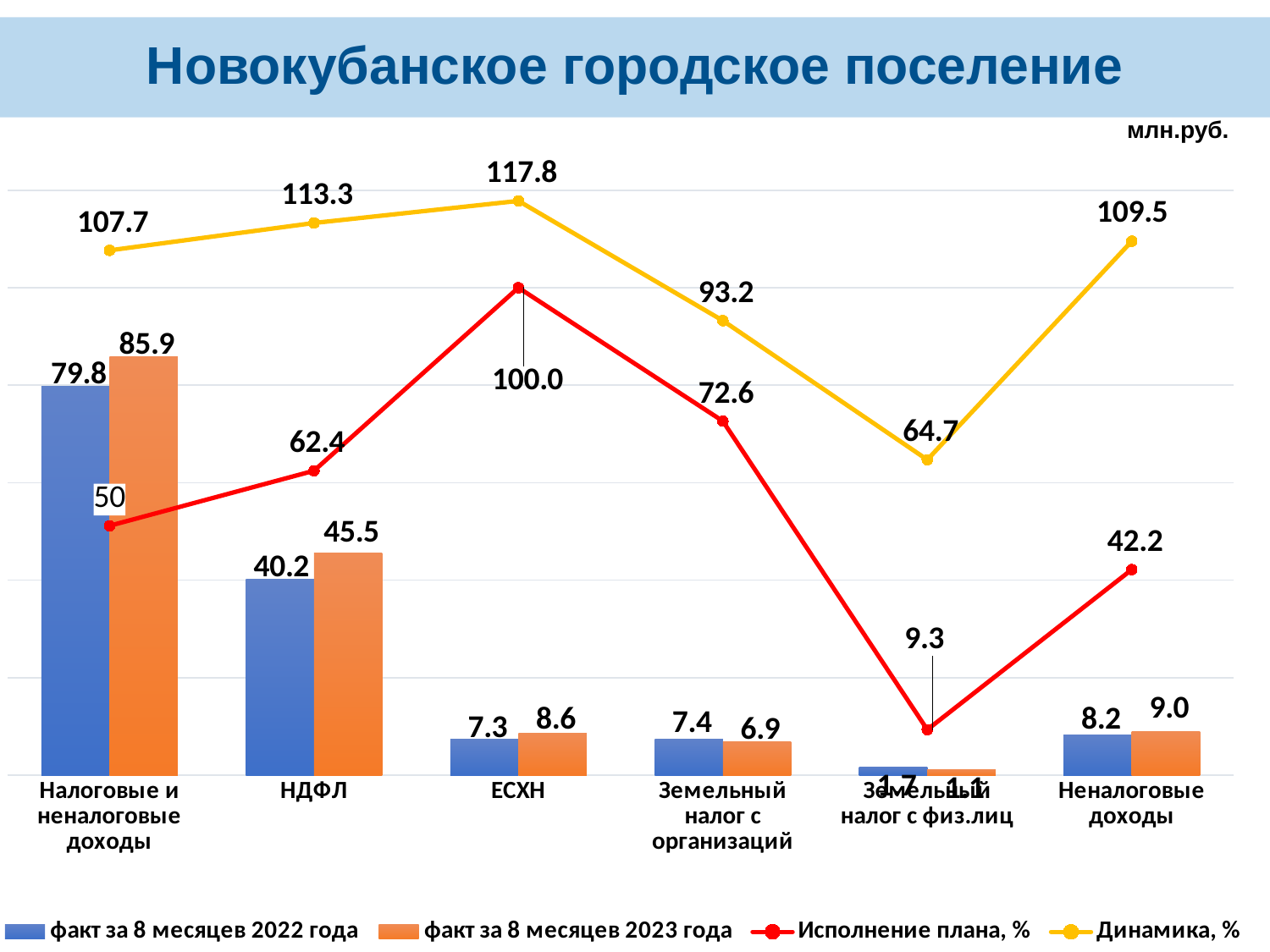
Which category has the highest 'Динамика, %' value? ЕСХН What is the 'Динамика, %' value for ЕСХН? 117.8 What is the difference between the 2023 and 2022 values for 'Налоговые и неналоговые доходы'? 6.1 For 'Земельный налог с организаций', which is larger: the 2022 value or the 2023 value? 2022 value (7.4) What is the value of 'факт за 8 месяцев 2022 года' for 'Налоговые и неналоговые доходы'? 79.8 What is the value of 'факт за 8 месяцев 2023 года' for НДФЛ? 45.5 How many series does the legend list? 4 How many categories are shown on the x axis? 6 What kind of chart is this? Combination bar and line chart What is the 'Исполнение плана, %' value for 'Неналоговые доходы'? 42.2 What unit is indicated in the top right corner of the chart? млн.руб. Which category has the lowest 'Исполнение плана, %' value? Земельный налог с физ.лиц